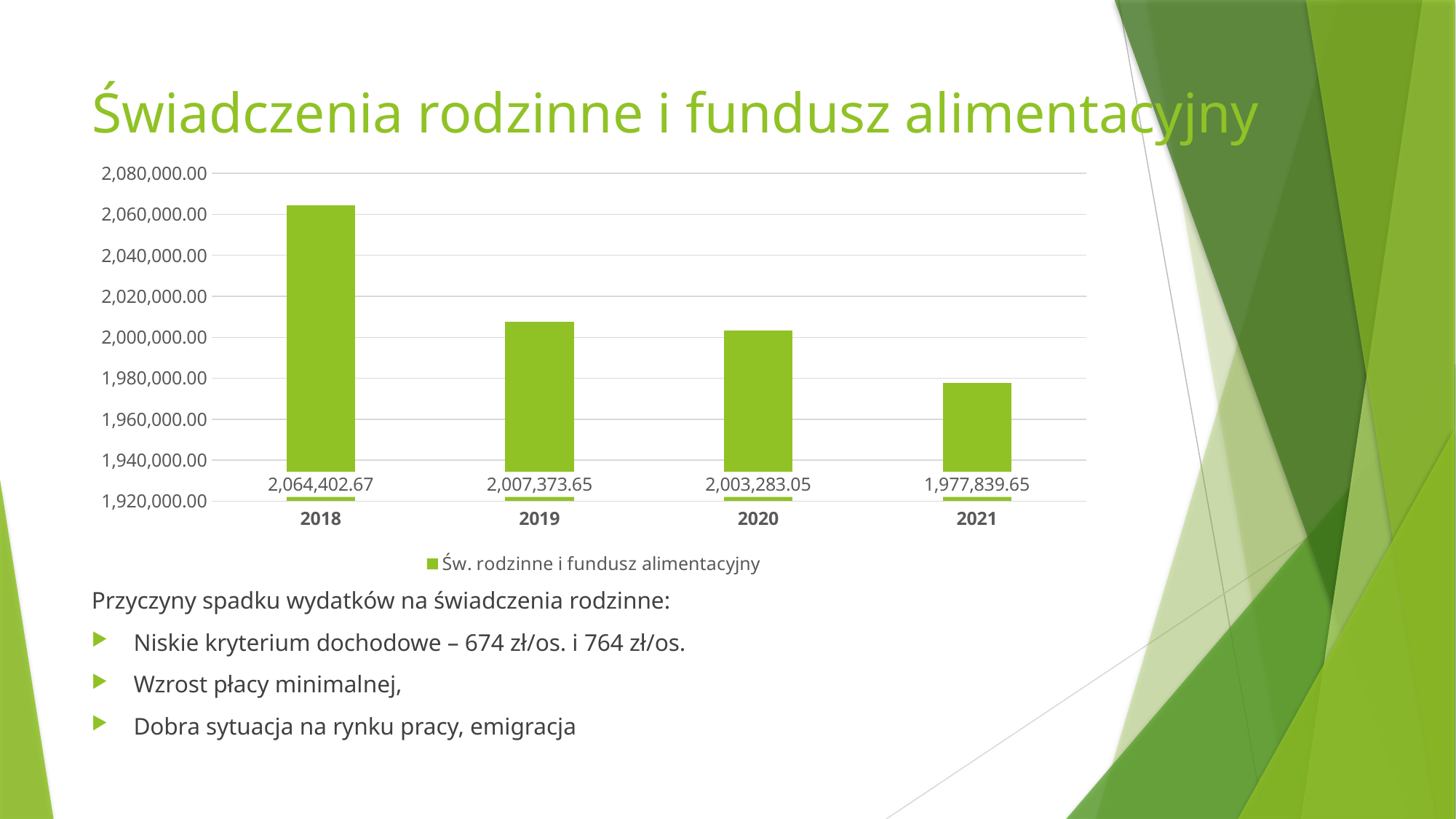
What is the difference between the values for 2020 and 2021? 25,443.40 How many years are shown on the x axis? 4 Do the values rise or fall from 2018 to 2021? fall What is the value for 2019? 2,007,373.65 What kind of chart is shown on the slide? bar chart What is the value for 2021? 1,977,839.65 Which year has the lowest value? 2021 Which is larger, the value for 2018 or the value for 2021? 2018 Which year has the highest value? 2018 Is the value for 2021 greater or less than 1,980,000.00? less What is the difference between the values for 2018 and 2019? 57,029.02 What is the value for 2018? 2,064,402.67